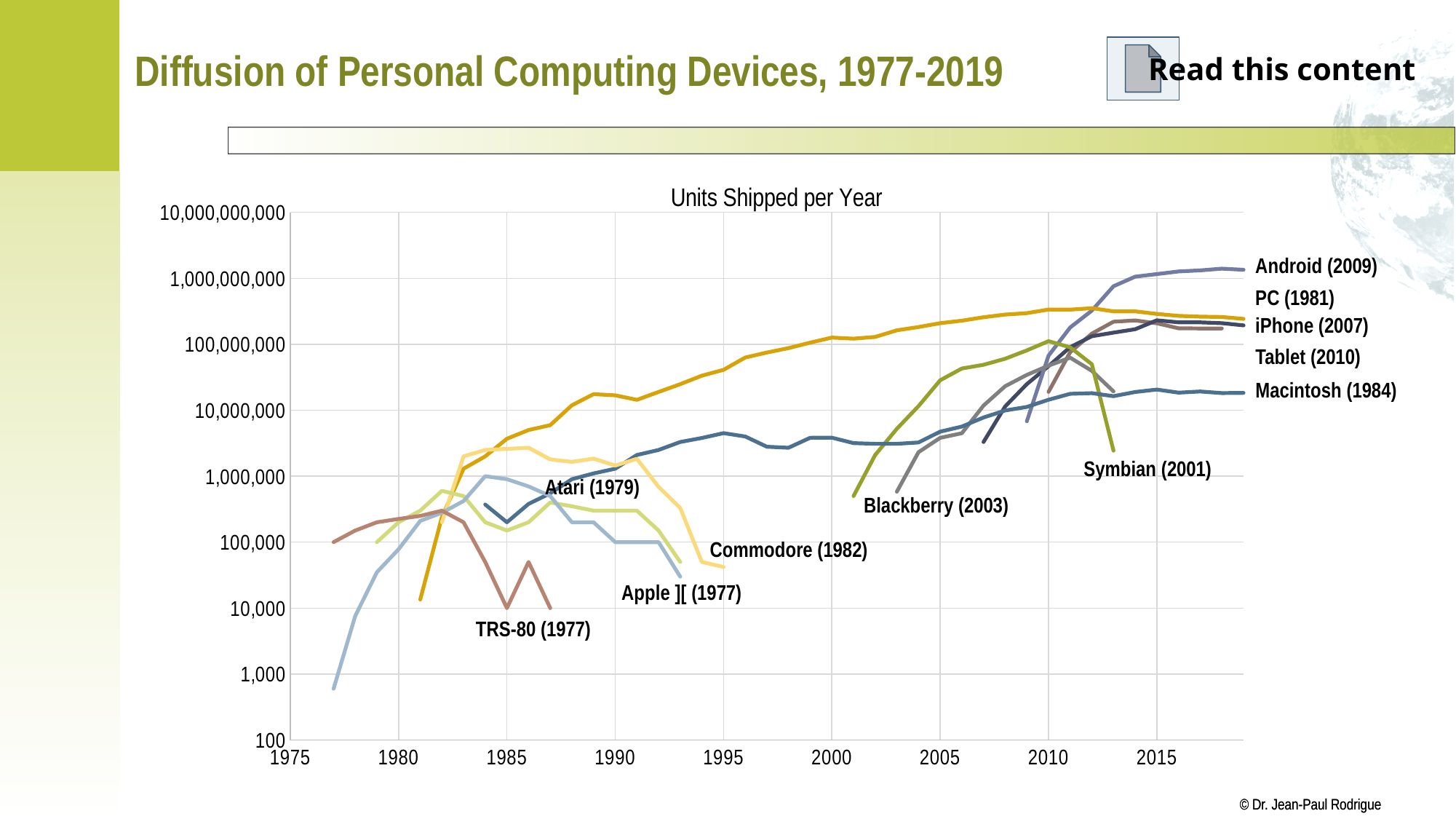
Which series reaches the highest value on the chart? Android (2009) Is the value for PC in 2018 greater or less than 1,000,000,000? less Is the value for Android in 2018 greater or less than 1,000,000,000? greater How many device series are labelled on the chart? 11 What kind of chart is shown on the slide? Line chart Which is larger in 2018, the value for iPhone or the value for Macintosh? iPhone Is the value for Macintosh in 2015 greater or less than 10,000,000? greater Does the Symbian series rise or fall after 2010? Fall Which is larger in 2018, the value for Android or the value for PC? Android What is the highest value shown on the vertical axis? 10,000,000,000 What is the title of the chart? Units Shipped per Year